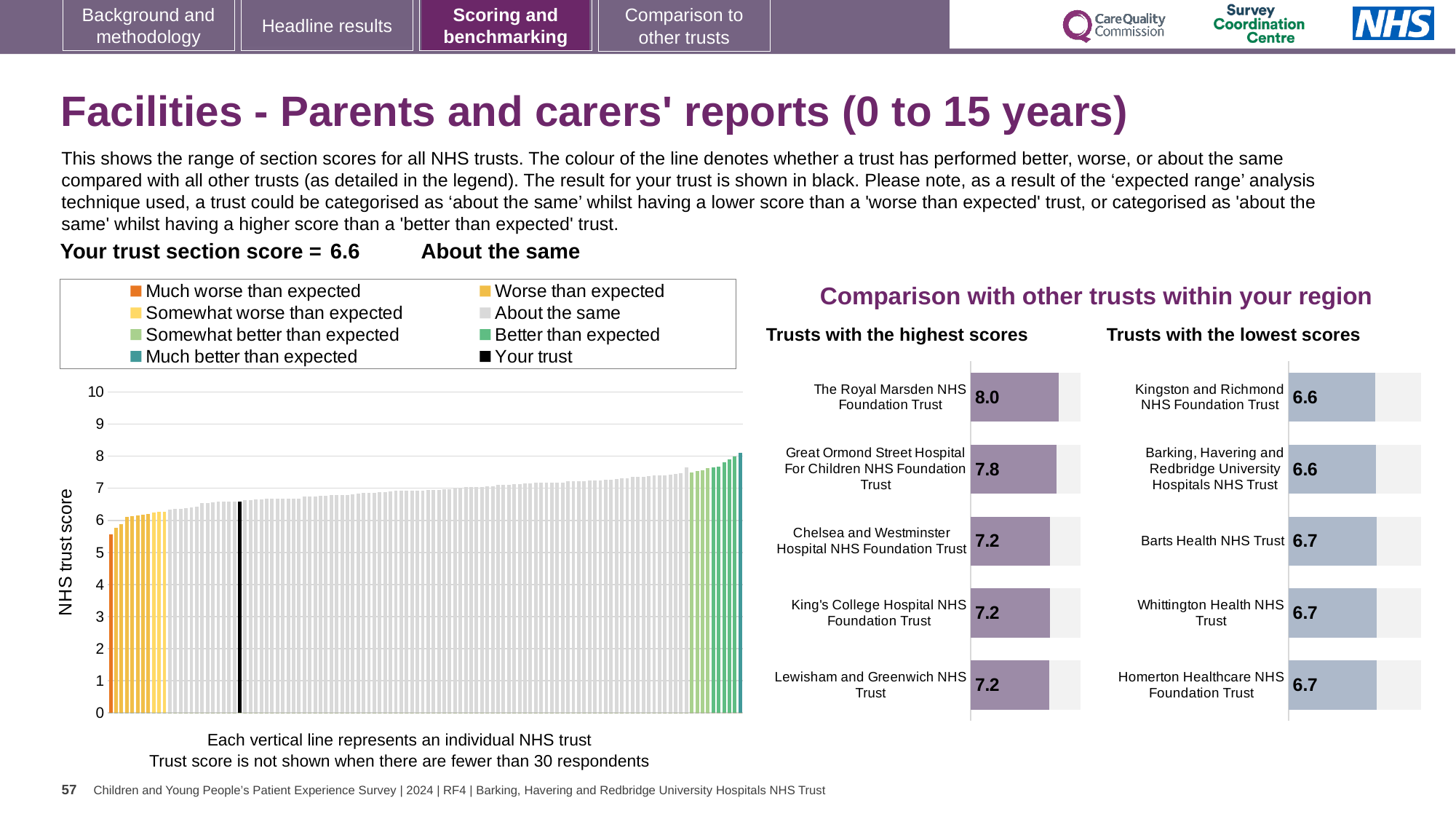
How many entries does the legend of the large chart on the left list? 8 In the 'Trusts with the lowest scores' chart, what is the score for Kingston and Richmond NHS Foundation Trust? 6.6 In the 'Trusts with the lowest scores' chart, what is the difference between the scores of Homerton Healthcare NHS Foundation Trust and Barking, Havering and Redbridge University Hospitals NHS Trust? 0.1 In the large chart on the left, is the value of the black bar representing your trust greater or less than 7? less In the 'Trusts with the highest scores' chart, what is the score for Great Ormond Street Hospital For Children NHS Foundation Trust? 7.8 In the 'Trusts with the highest scores' chart, what is the score for The Royal Marsden NHS Foundation Trust? 8.0 How many trusts are shown in the 'Trusts with the highest scores' chart? 5 Which is larger: the score for Chelsea and Westminster Hospital NHS Foundation Trust in the 'Trusts with the highest scores' chart or the score for Whittington Health NHS Trust in the 'Trusts with the lowest scores' chart? Chelsea and Westminster Hospital NHS Foundation Trust In the 'Trusts with the lowest scores' chart, what is the score for Barts Health NHS Trust? 6.7 In the 'Trusts with the highest scores' chart, which trust has the highest score? The Royal Marsden NHS Foundation Trust In the 'Trusts with the highest scores' chart, what is the difference between the scores of The Royal Marsden NHS Foundation Trust and Great Ormond Street Hospital For Children NHS Foundation Trust? 0.2 What kind of chart is the large chart on the left showing NHS trust scores? Bar chart